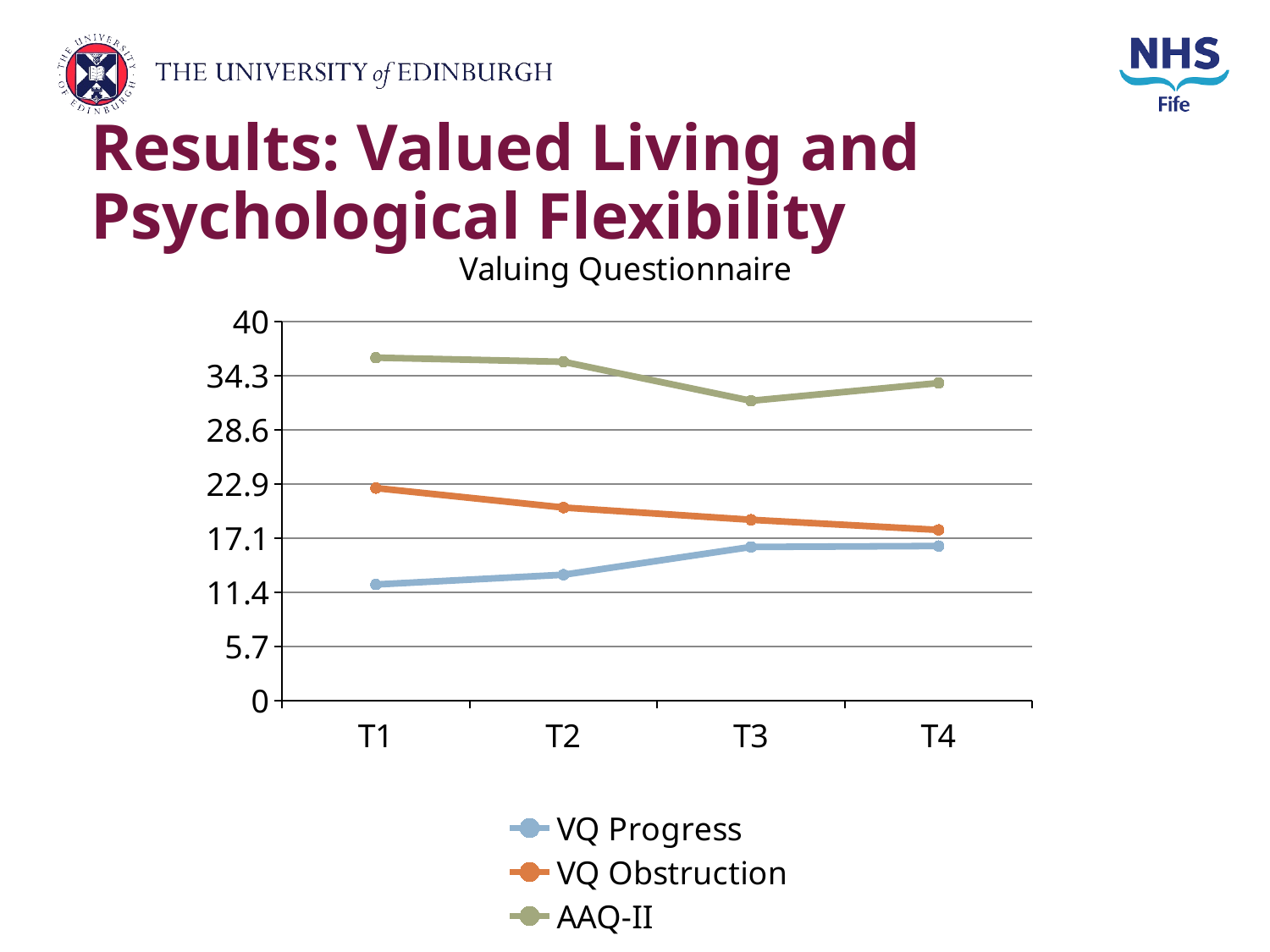
What is the title of the chart? Valuing Questionnaire At which time point is VQ Obstruction highest? T1 Is the value for AAQ-II at T1 greater or less than 34.3? greater How many time points are shown on the x axis? 4 What kind of chart is shown on the slide? Line chart At which time point is AAQ-II lowest? T3 At T4, which is larger: VQ Progress or VQ Obstruction? VQ Obstruction Is the value for VQ Progress at T1 greater or less than 17.1? less Does VQ Obstruction rise or fall from T1 to T4? fall Is the value for VQ Obstruction at T1 greater or less than 17.1? greater How many series does the legend list? 3